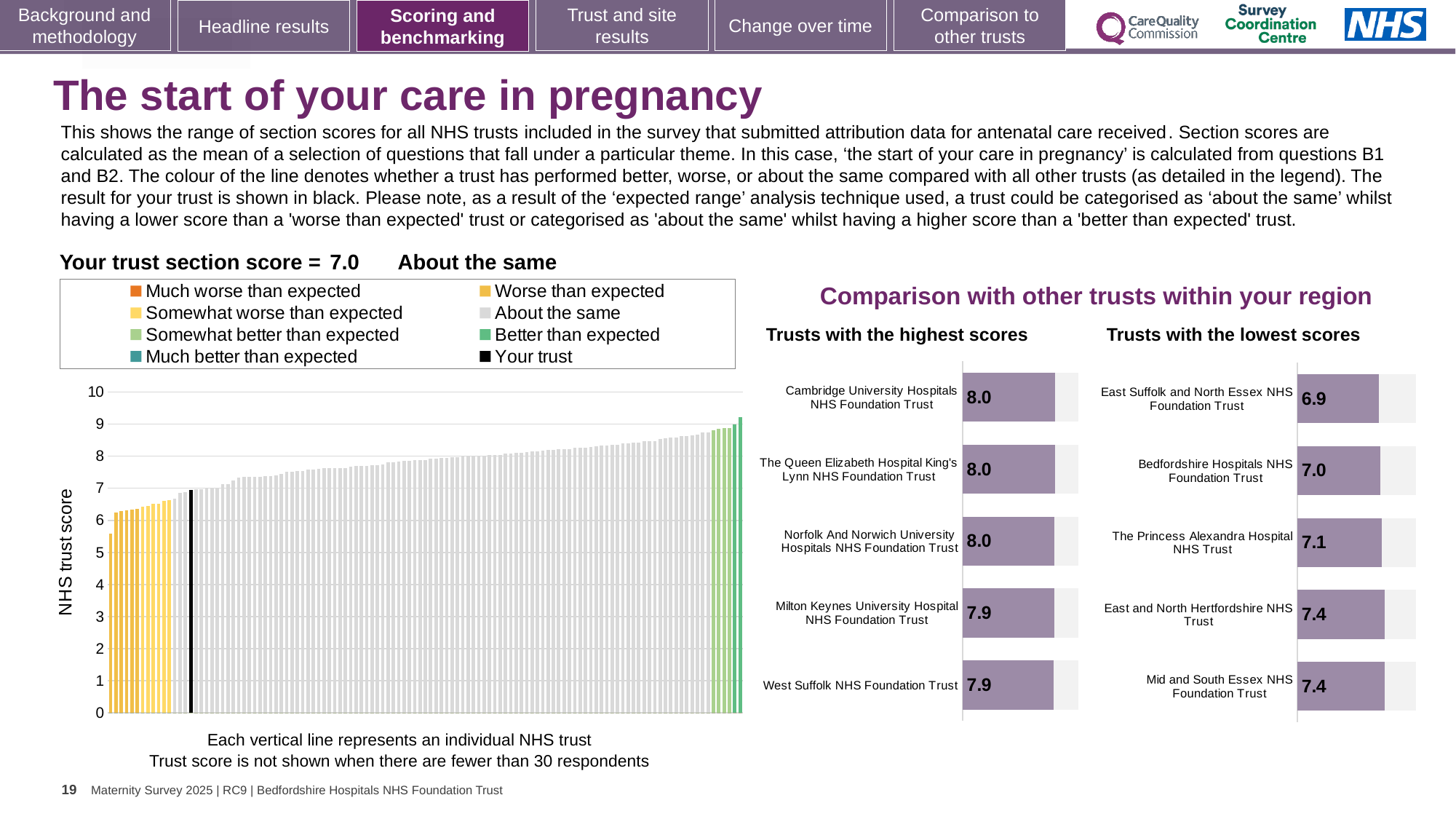
What kind of chart is the large chart on the left showing NHS trust scores? bar chart In the large chart on the left, do the trust scores rise or fall from left to right? rise In the large chart on the left, is the value of the leftmost bar greater or less than 6? less In the 'Trusts with the highest scores' chart, what is the score for West Suffolk NHS Foundation Trust? 7.9 In the large chart on the left, is the value of the black bar (your trust) greater or less than 8? less How many trusts are shown in the 'Trusts with the highest scores' chart? 5 In the 'Trusts with the lowest scores' chart, what is the difference between the scores of Mid and South Essex NHS Foundation Trust and East Suffolk and North Essex NHS Foundation Trust? 0.5 In the 'Trusts with the lowest scores' chart, which has the higher score: The Princess Alexandra Hospital NHS Trust or Bedfordshire Hospitals NHS Foundation Trust? The Princess Alexandra Hospital NHS Trust How many entries does the legend above the large chart on the left list? 8 In the 'Trusts with the highest scores' chart, what is the score for Cambridge University Hospitals NHS Foundation Trust? 8.0 In the large chart on the left, what is the label on the vertical axis? NHS trust score In the 'Trusts with the lowest scores' chart, which trust has the lowest score? East Suffolk and North Essex NHS Foundation Trust